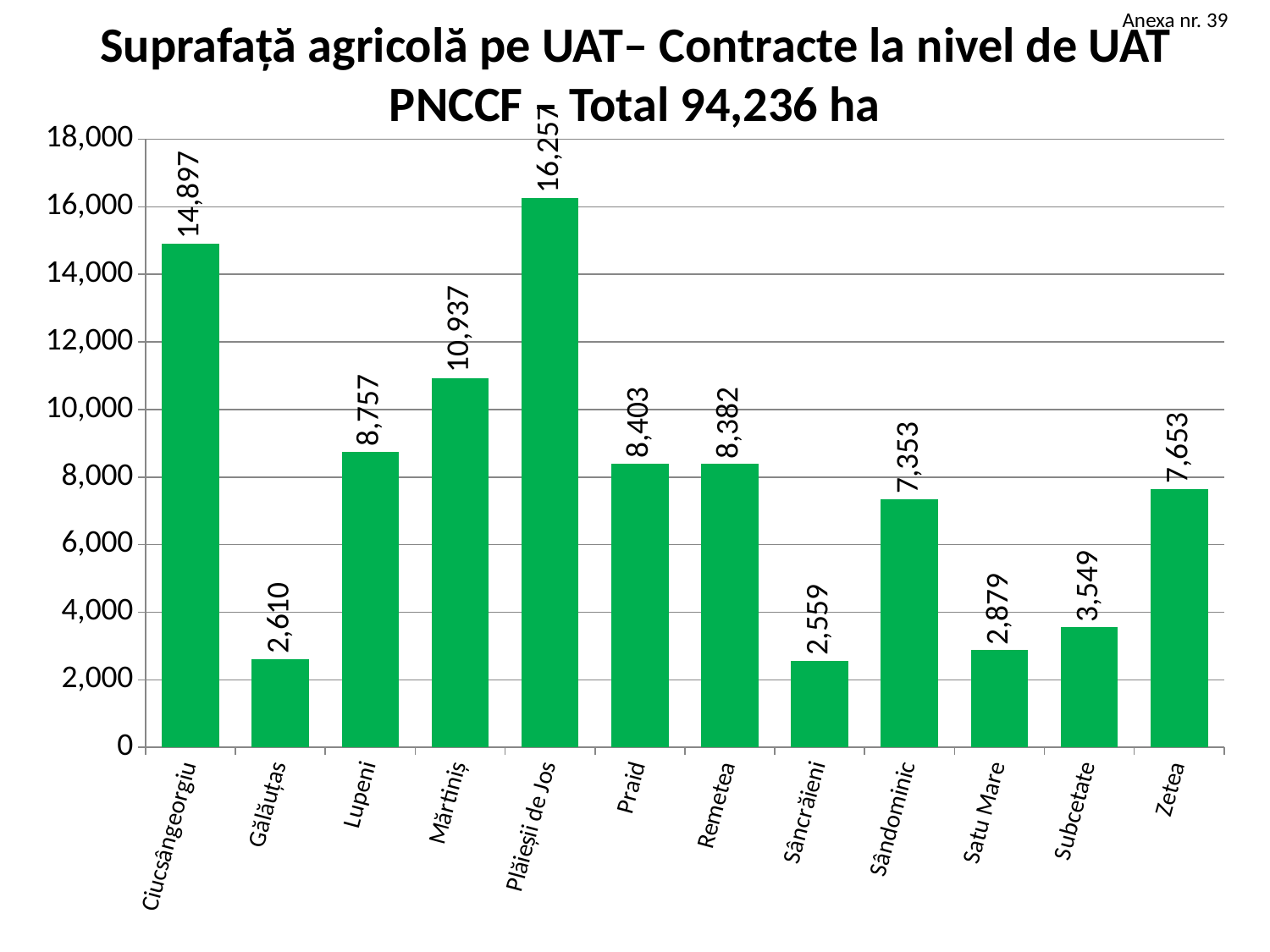
What is the difference between the values for Satu Mare and Gălăuțaș? 269 What is the difference between the values for Plăieșii de Jos and Ciucsângeorgiu? 1,360 What is the value for Ciucsângeorgiu? 14,897 Which category has the lowest value? Sâncrăieni Is the value for Sândominic greater or less than 8,000? less What kind of chart is shown on the slide? bar chart Which is larger, the value for Lupeni or the value for Zetea? Lupeni Which category has the highest value? Plăieșii de Jos How many categories are shown on the x axis? 12 What is the value for Subcetate? 3,549 What total is stated in the chart title? 94,236 ha What is the value for Mărtiniș? 10,937